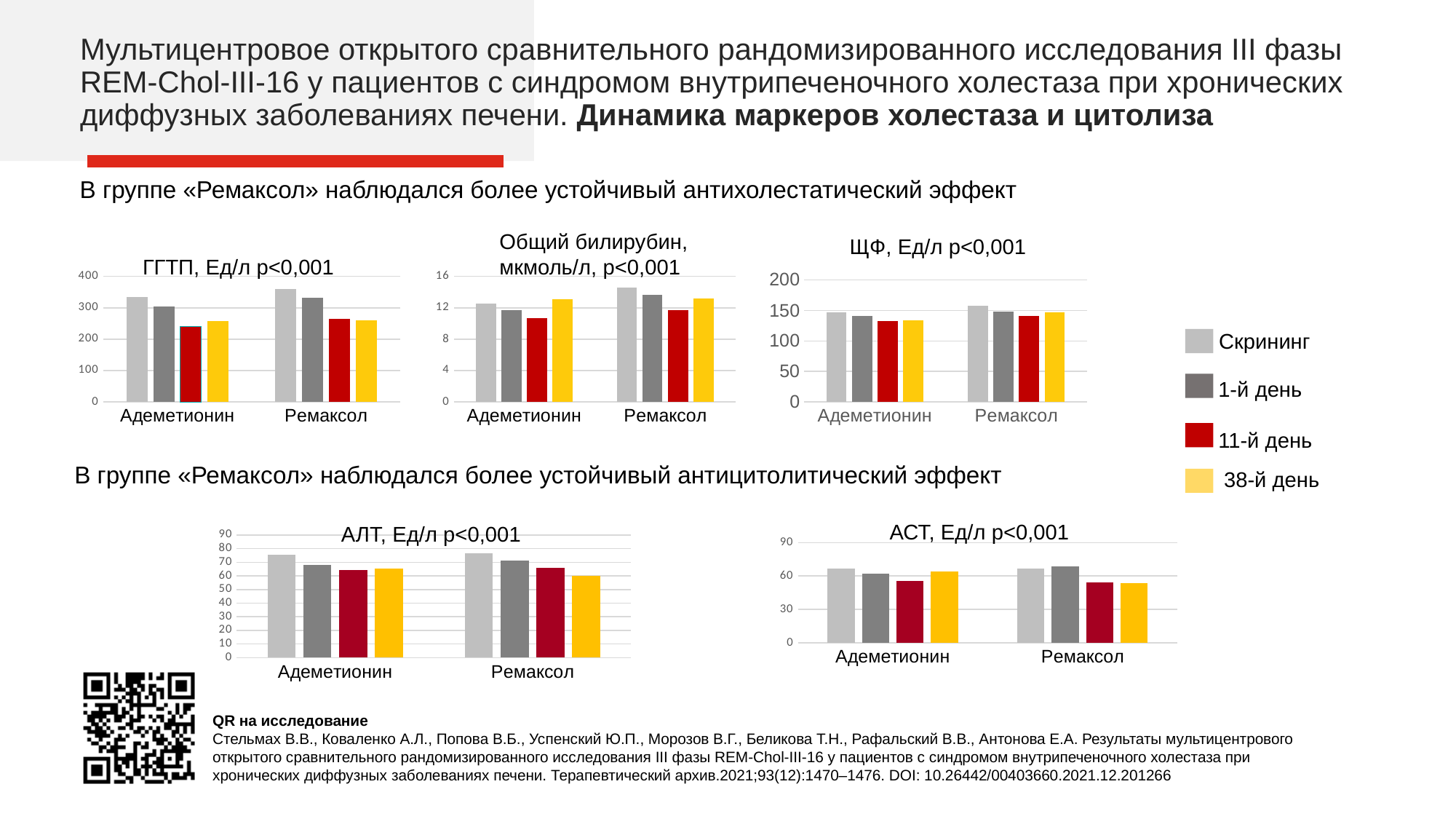
In the ГГТП, Ед/л p<0,001 chart, is the 11-й день value for Адеметионин greater or less than 300? less In the АСТ, Ед/л p<0,001 chart, is the 11-й день value for Ремаксол greater or less than 60? less In the АЛТ, Ед/л p<0,001 chart, is the 38-й день value for Ремаксол greater or less than 70? less In the АЛТ, Ед/л p<0,001 chart, how many categories are shown on the x axis? 2 In the АЛТ, Ед/л p<0,001 chart, do the values for Ремаксол rise or fall from Скрининг to 38-й день? fall In the ГГТП, Ед/л p<0,001 chart, which bar is the highest? Скрининг for Ремаксол What kind of chart is the ГГТП, Ед/л p<0,001 chart? bar chart How many series does the legend on the slide list? 4 Which colour does the legend use for the 11-й день series? red